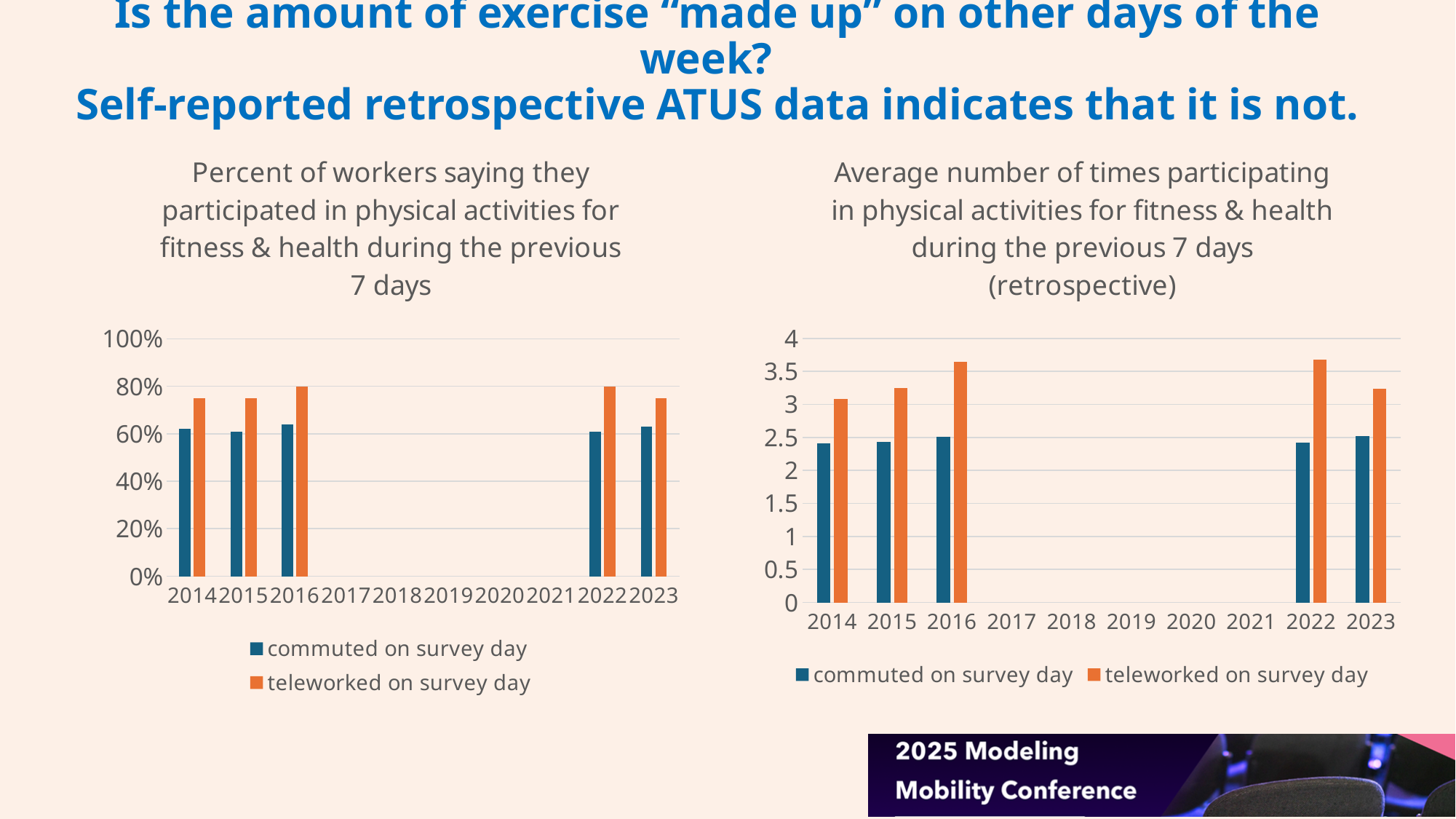
In the left chart, is the value for 'teleworked on survey day' in 2016 greater or less than 60%? greater How many series does the legend of the right chart, 'Average number of times participating in physical activities for fitness & health during the previous 7 days (retrospective)', list? 2 In the left chart, which is larger in 2014: 'commuted on survey day' or 'teleworked on survey day'? teleworked on survey day What colour are the 'teleworked on survey day' bars in the left chart? orange What kind of chart is the left chart, 'Percent of workers saying they participated in physical activities for fitness & health during the previous 7 days'? bar chart In the right chart, is the value for 'teleworked on survey day' in 2022 greater or less than 3.5? greater In the left chart, is the value for 'commuted on survey day' in 2014 greater or less than 80%? less In the right chart, which is larger in 2023: 'commuted on survey day' or 'teleworked on survey day'? teleworked on survey day How many year labels are shown on the x axis of the left chart? 10 What are the two legend entries of the left chart? commuted on survey day; teleworked on survey day In the right chart, for how many years are bars actually plotted? 5